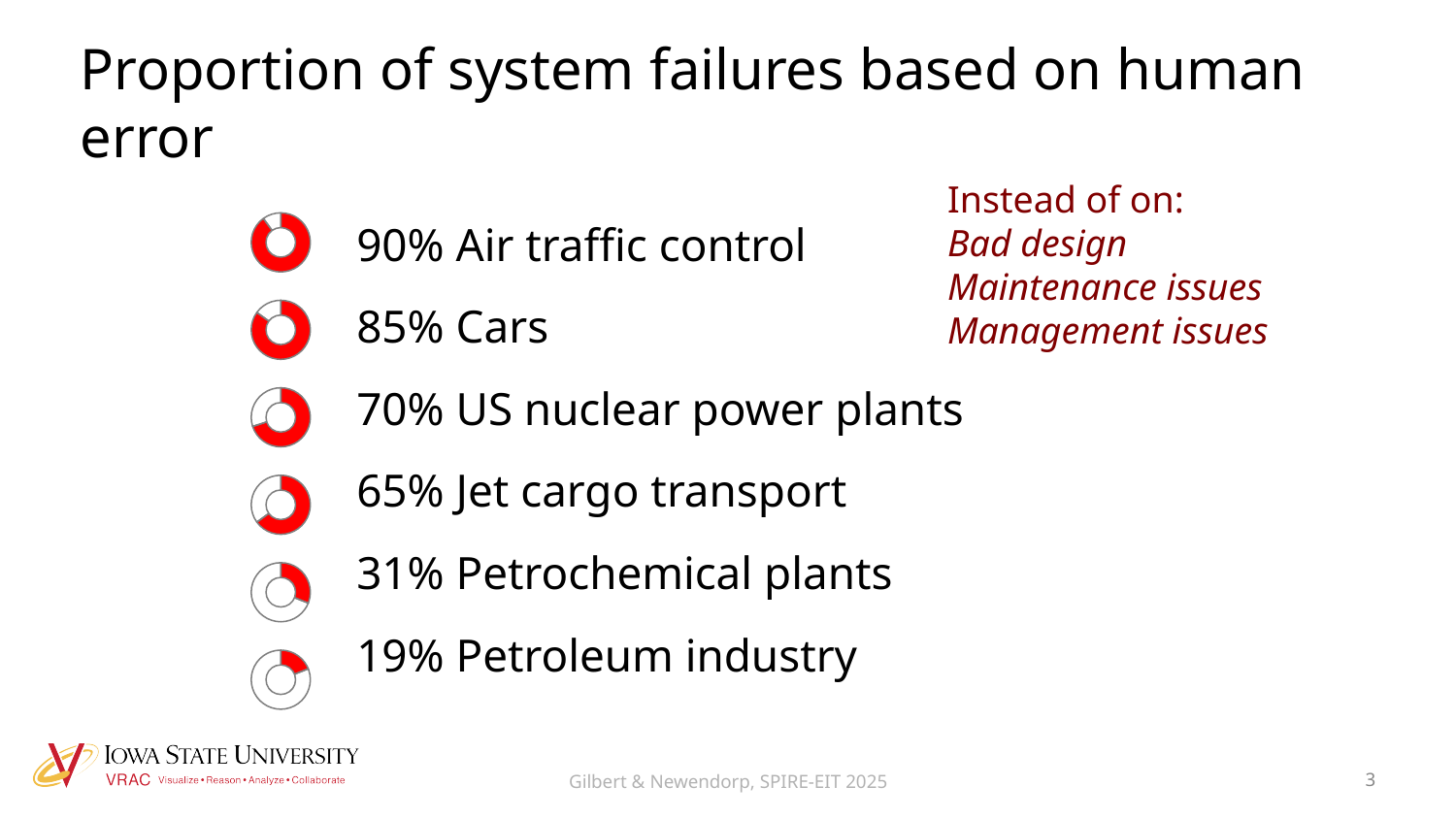
What percentage is shown for the petroleum industry? 19% What percentage is shown for cars? 85% What percentage of system failures are attributed to human error for air traffic control? 90% What percentage is shown for jet cargo transport? 65% Which category has the highest proportion of system failures based on human error? Air traffic control What kind of chart is used to show each percentage on the slide? Donut (pie) chart What is the difference between the percentages for air traffic control and petrochemical plants? 59% Which category has the lowest proportion of system failures based on human error? Petroleum industry What percentage is shown for US nuclear power plants? 70% How many donut charts are shown on the slide? 6 Which is larger, the percentage for cars or the percentage for jet cargo transport? Cars What colour is used for the filled portion of each donut chart? Red